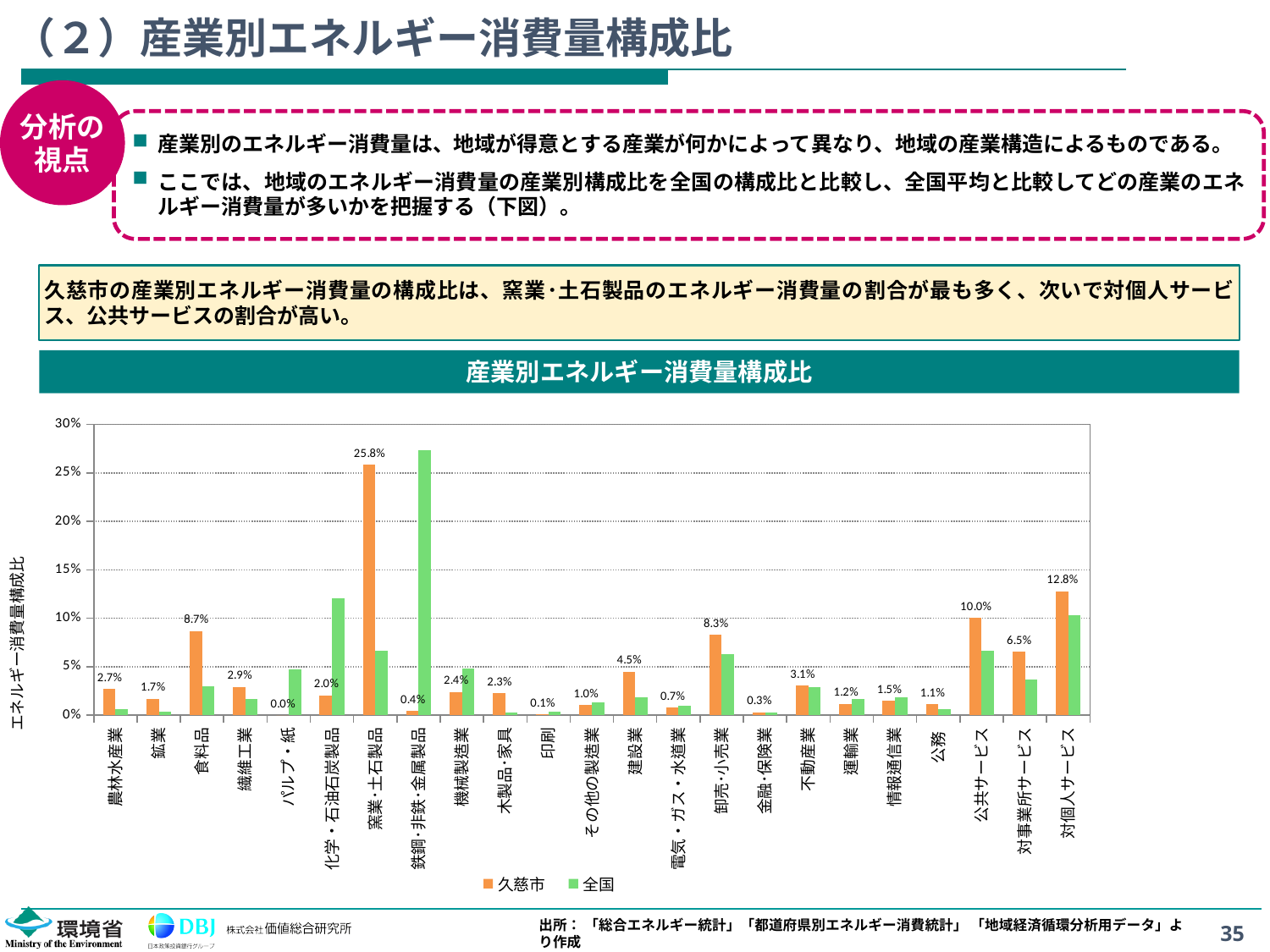
Which category has the lowest value for 久慈市? パルプ・紙 Is the value for 全国 in the 鉄鋼・非鉄・金属製品 category greater or less than 25%? greater Which category has the highest value for 久慈市? 窯業・土石製品 What is the value for 久慈市 in the 窯業・土石製品 category? 25.8% What is the value for 久慈市 in the 公共サービス category? 10.0% Is the value for 全国 in the 化学・石油石炭製品 category greater or less than 10%? greater What kind of chart is shown on the slide? Bar chart For 久慈市, which is larger: 食料品 or 卸売・小売業? 食料品 What is the difference between the 久慈市 values for 対個人サービス and 公共サービス? 2.8% What is the value for 久慈市 in the 対個人サービス category? 12.8% How many industry categories are shown on the x axis? 23 How many series does the legend list? 2